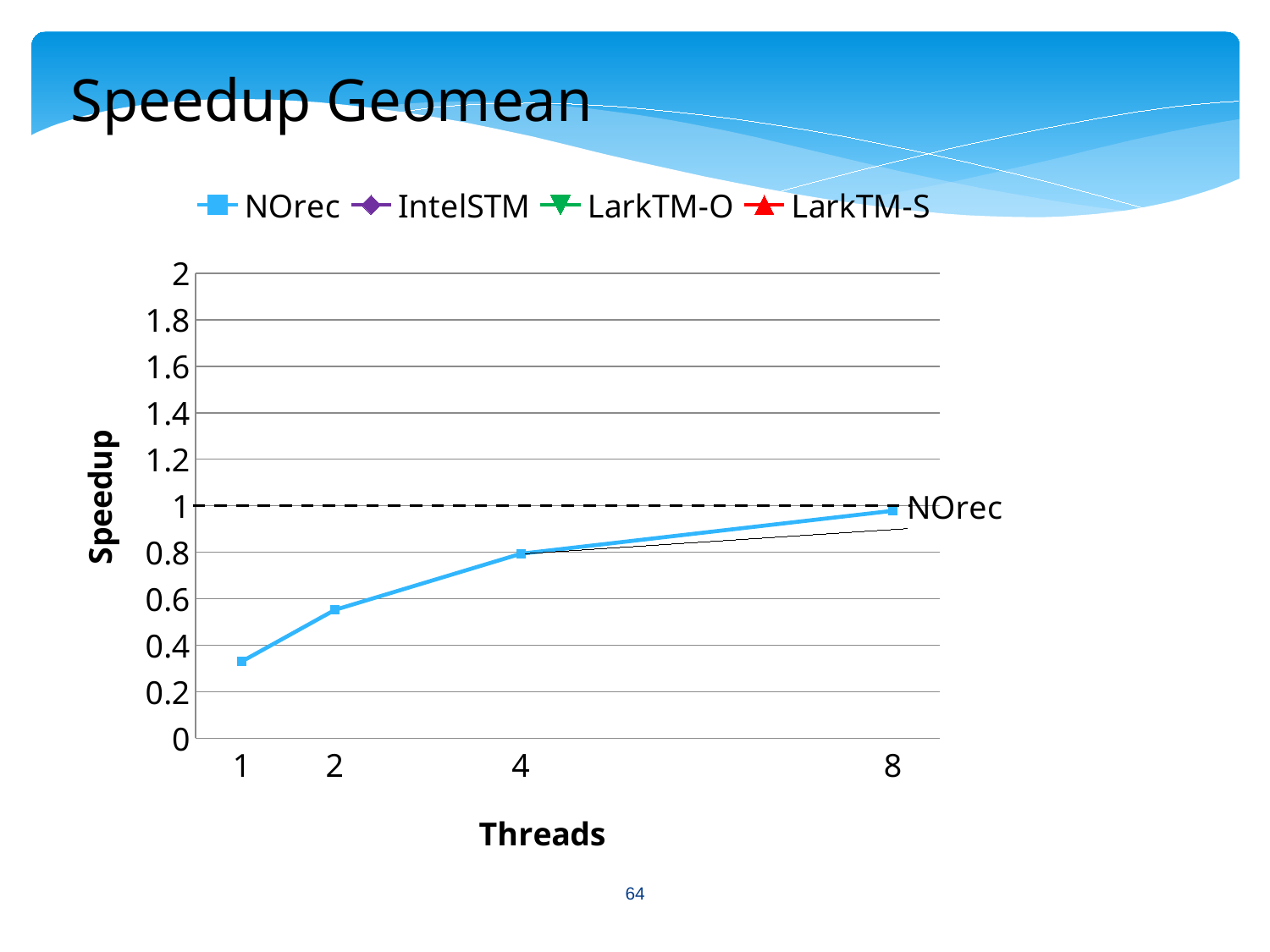
Is the NOrec speedup at 8 threads greater or less than 0.8? greater Is the NOrec speedup at 1 thread greater or less than 0.4? less Is the NOrec speedup at 2 threads greater or less than 0.4? greater What kind of chart is shown on the slide? line chart How many series does the legend list? 4 At which thread count is the NOrec speedup highest? 8 How many thread counts are shown on the x axis? 4 What is the title of the chart? Speedup Geomean What is the label of the y axis? Speedup At which thread count is the NOrec speedup lowest? 1 Does the NOrec speedup rise or fall as the number of threads increases? rises